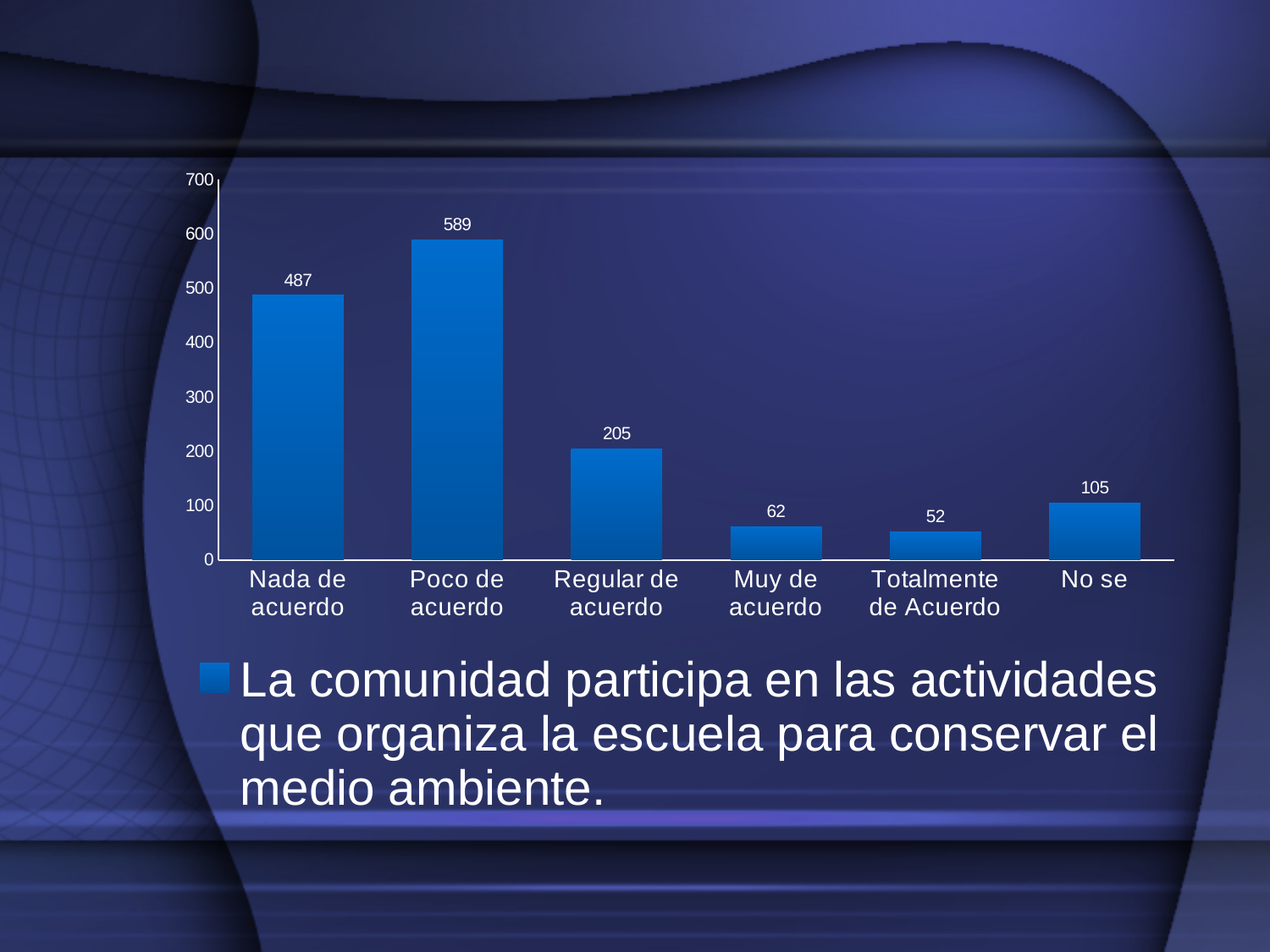
What is the value for "Nada de acuerdo"? 487 What is the difference between the values for "Poco de acuerdo" and "Nada de acuerdo"? 102 How many categories are shown on the x axis? 6 Which is larger, the value for "Muy de acuerdo" or the value for "No se"? No se Which category has the lowest value? Totalmente de Acuerdo What is the difference between the values for "Regular de acuerdo" and "No se"? 100 What is the value for "Poco de acuerdo"? 589 Which category has the highest value? Poco de acuerdo What is the value for "No se"? 105 Is the value for "Regular de acuerdo" greater or less than 300? less What is the maximum value shown on the vertical axis? 700 What kind of chart is shown on the slide? bar chart